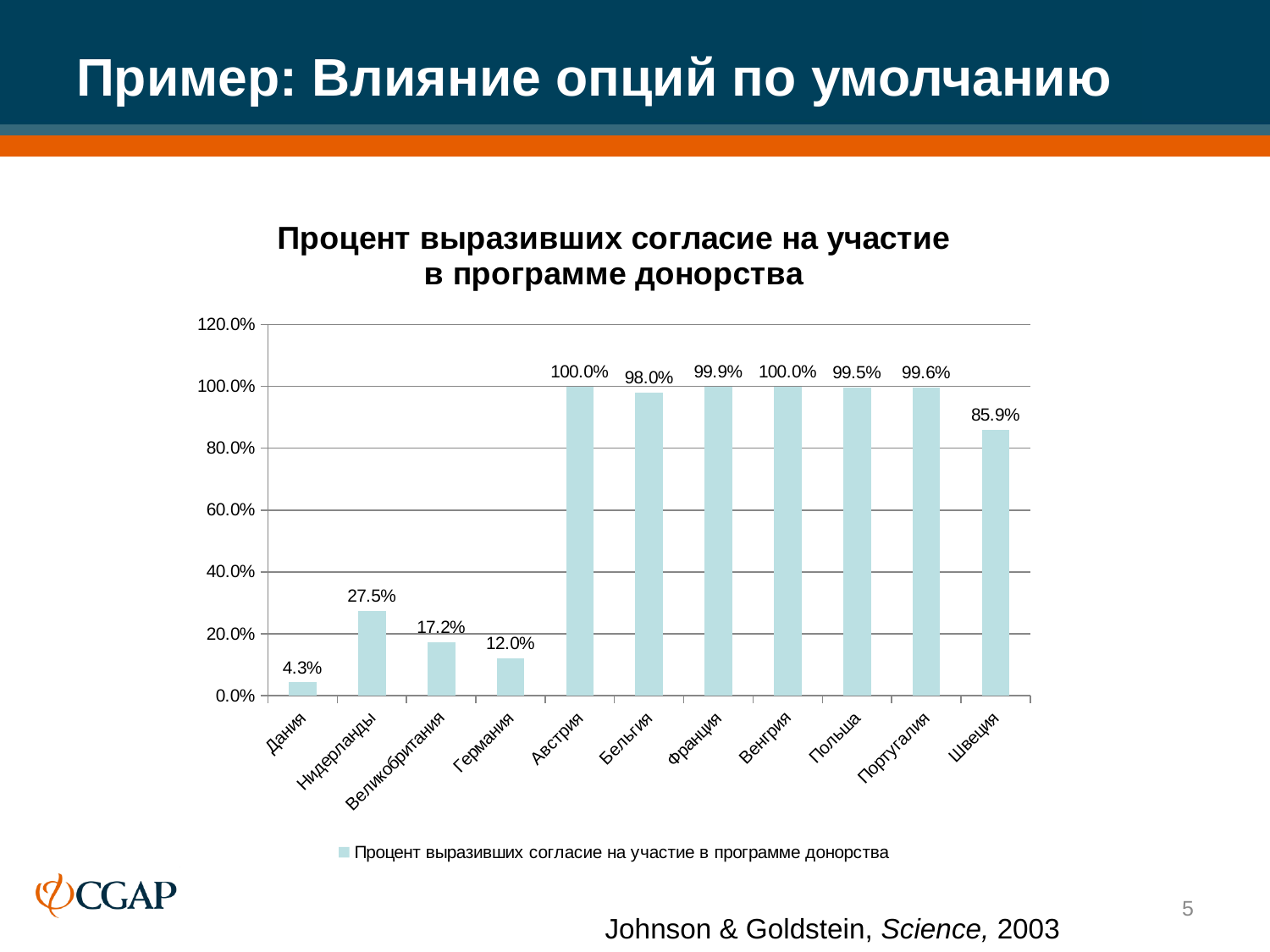
What kind of chart is shown on the slide? Bar chart How many countries are shown on the x axis? 11 What is the value for Швеция? 85.9% What is the value for Дания? 4.3% What is the value for Бельгия? 98.0% How many series does the legend list? 1 Which country has the lowest value? Дания What is the difference between the values for Австрия and Швеция? 14.1% Which is larger, the value for Великобритания or the value for Германия? Великобритания What is the value for Нидерланды? 27.5% What is the difference between the values for Нидерланды and Германия? 15.5% Is the value for Швеция greater or less than 80.0%? greater